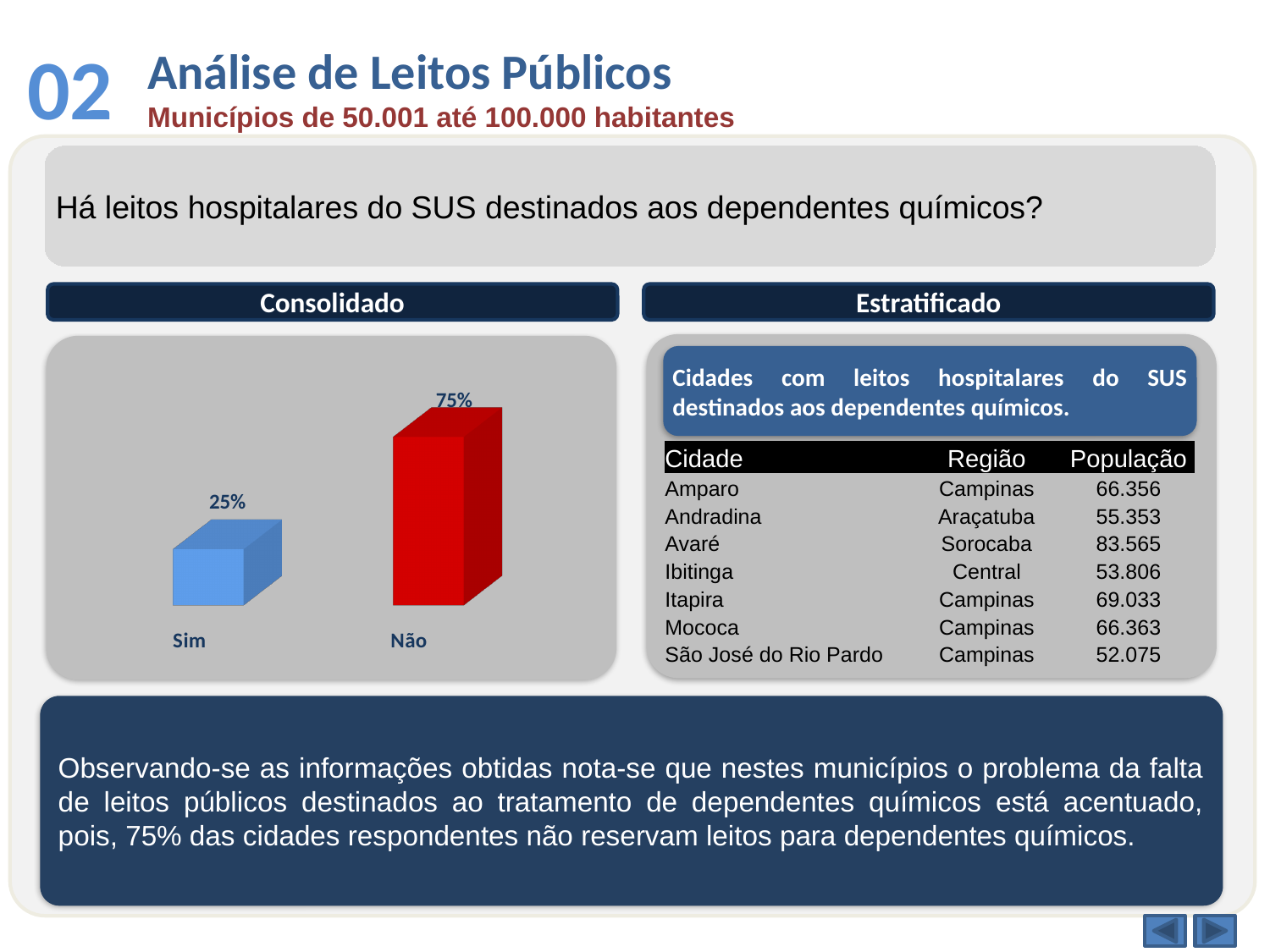
How many categories are shown in the Consolidado chart? 2 Which category has the highest value in the Consolidado chart? Não What is the value for "Sim" in the Consolidado chart? 25% In the Consolidado chart, which is larger: the value for "Sim" or the value for "Não"? Não What kind of chart is the Consolidado chart? Bar chart What colour is the "Sim" bar in the Consolidado chart? Blue Which category has the lowest value in the Consolidado chart? Sim What is the difference between the "Não" and "Sim" values in the Consolidado chart? 50% What colour is the "Não" bar in the Consolidado chart? Red What is the value for "Não" in the Consolidado chart? 75% What is the total of the two values shown in the Consolidado chart? 100%